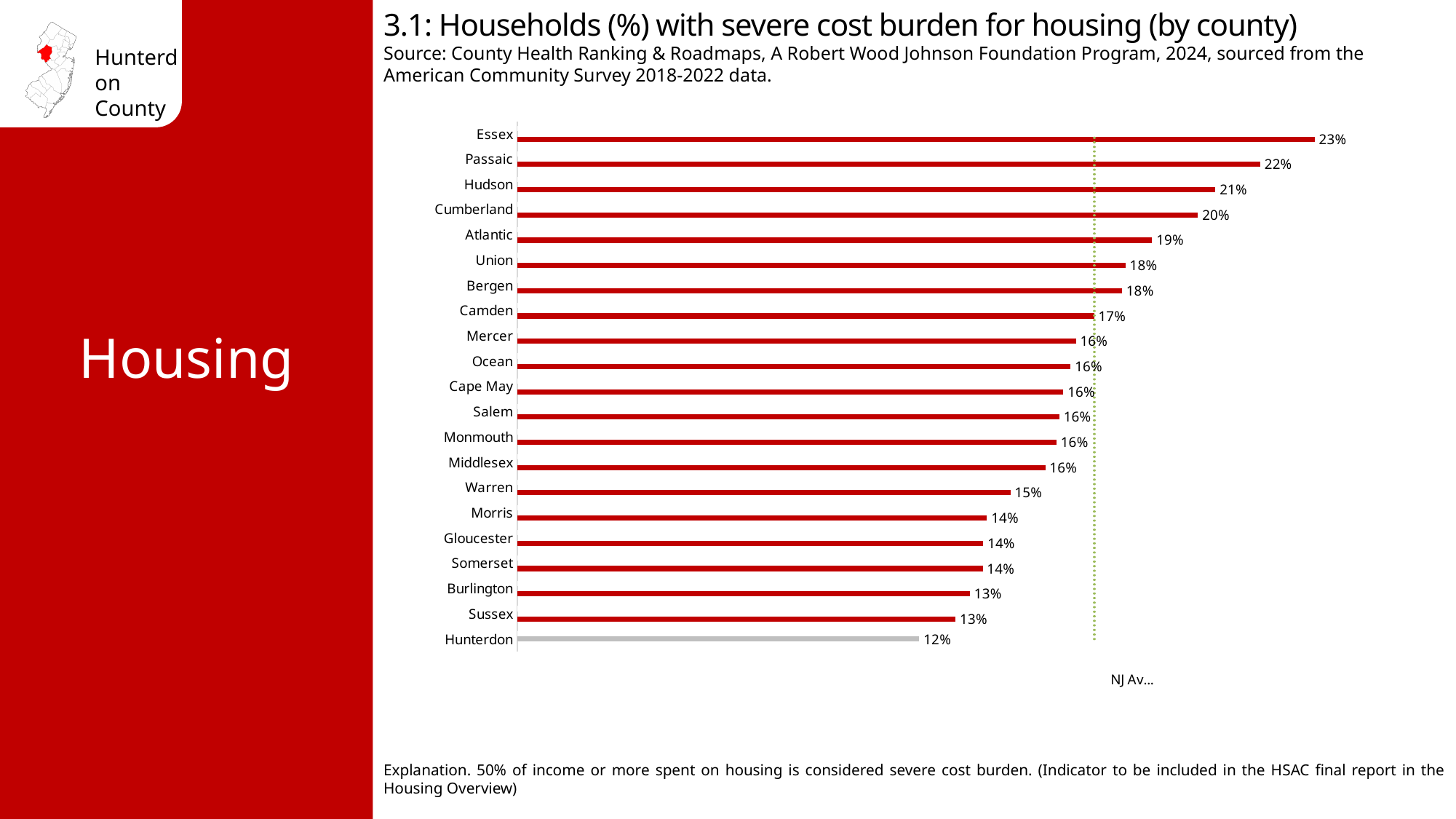
What is the difference between the values for Atlantic and Sussex? 6 percentage points What is the value for Cumberland? 20% Which is larger, the value for Passaic or the value for Hudson? Passaic What is the difference between the values for Essex and Hunterdon? 11 percentage points Which is larger, the value for Morris or the value for Warren? Warren Which county has the highest value? Essex What is the value for Warren? 15% Which county has the lowest value? Hunterdon How many counties are shown in the chart? 21 What kind of chart is shown on the slide? Bar chart What is the value for Hunterdon? 12% Which county's bar is coloured grey instead of red? Hunterdon